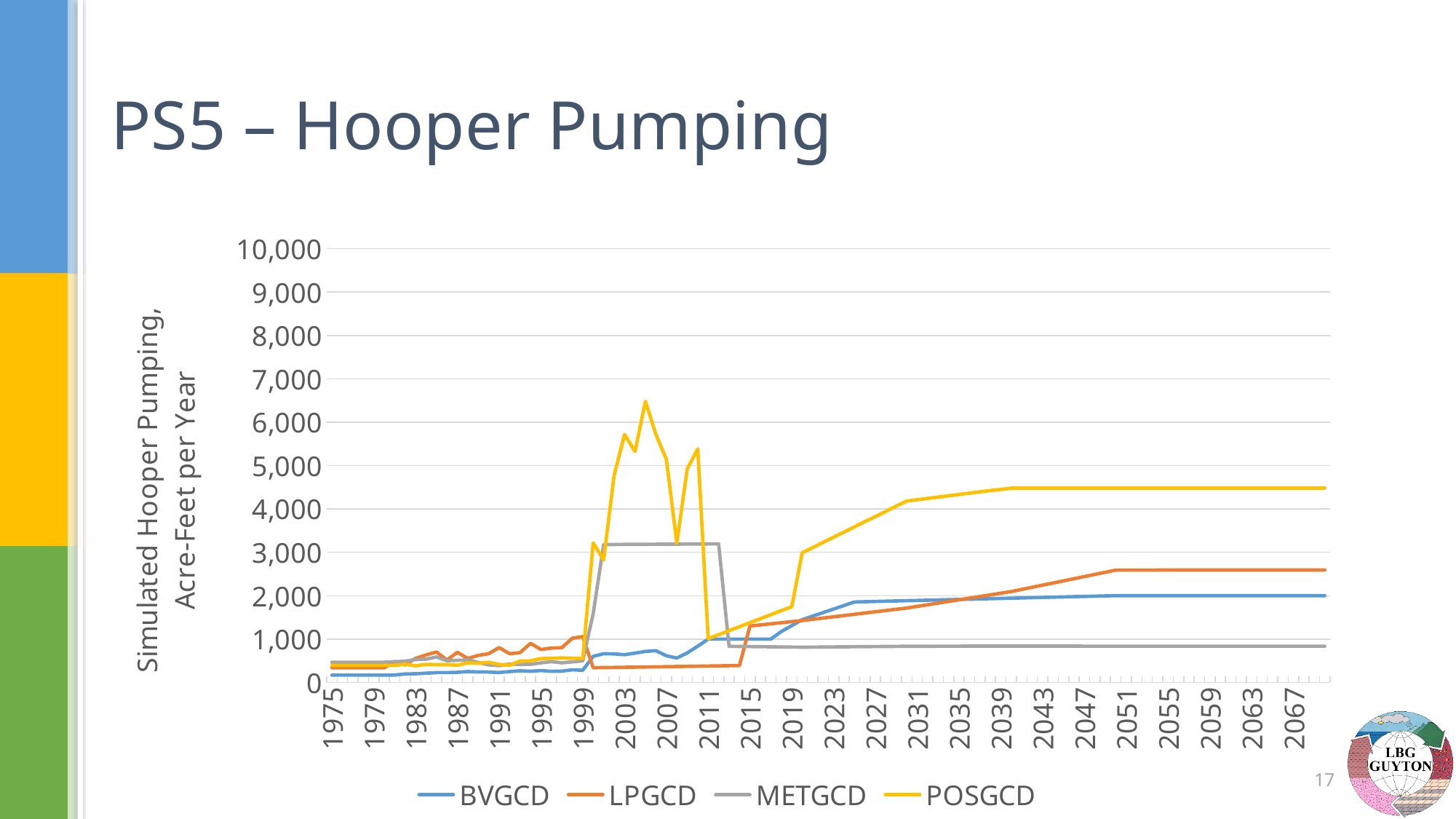
What is the title of the slide containing the chart? PS5 – Hooper Pumping Which series has the lowest value at the right end of the chart (2067)? METGCD Is the METGCD plateau between about 2001 and 2011 greater or less than 4,000? less How many series does the legend list? 4 What is the label on the vertical axis of the chart? Simulated Hooper Pumping, Acre-Feet per Year At 2067, which series has the larger value, BVGCD or LPGCD? LPGCD Is the value of BVGCD in 2067 greater or less than 3,000? less Which series reaches the highest value anywhere on the chart? POSGCD Is the value of LPGCD in 2067 greater or less than 2,000? greater Does the POSGCD series rise or fall between 2019 and 2039? rise What kind of chart is shown on the slide? Line chart